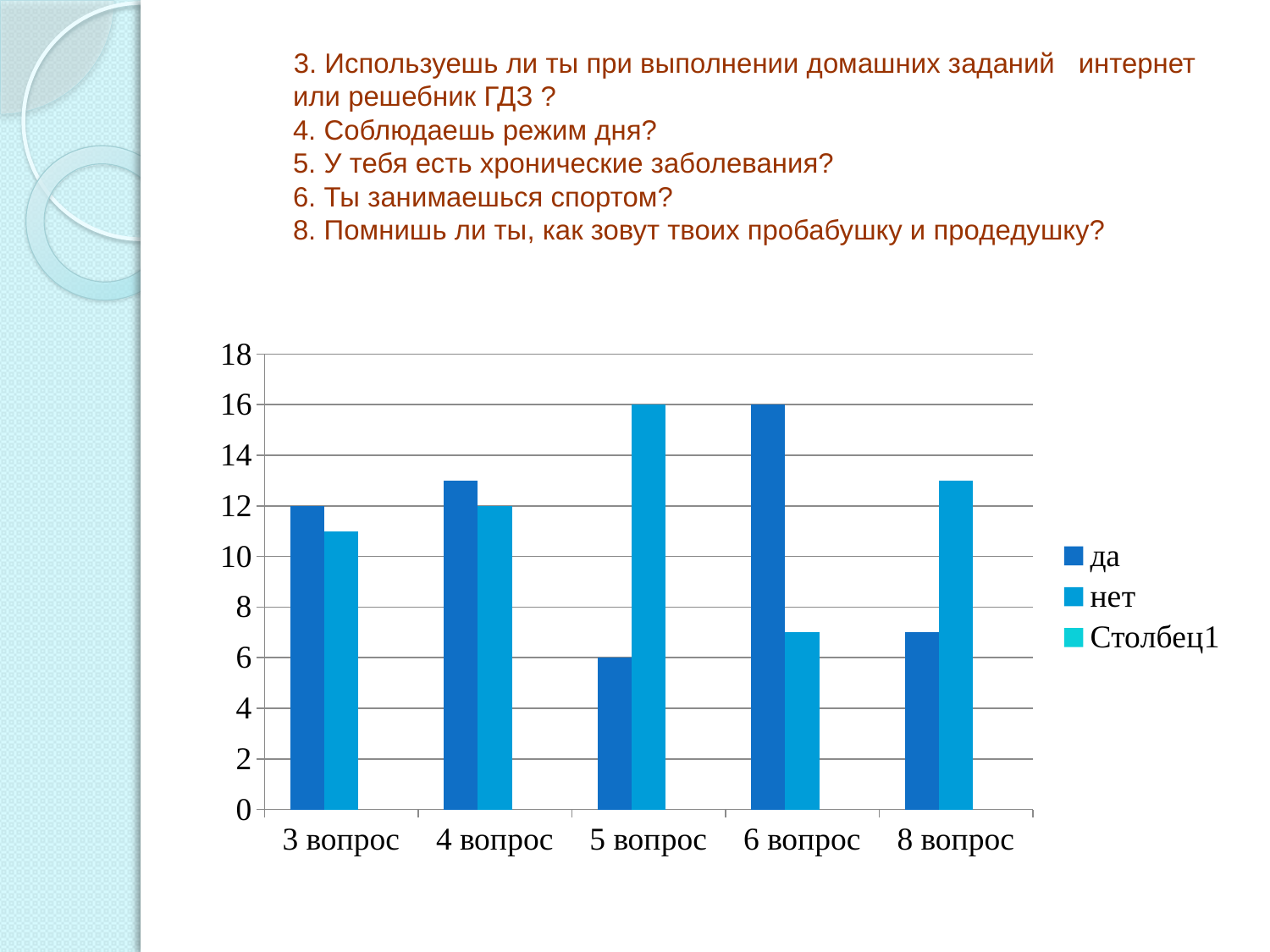
Which category has the highest value in the 'да' series? 6 вопрос Is the value of the 'нет' series for '6 вопрос' greater or less than 8? less For '5 вопрос', which series has the larger value, 'да' or 'нет'? нет How many series does the chart legend list? 3 What is the value of the 'да' series for '3 вопрос'? 12 How many categories are shown on the x axis of the chart? 5 Which category has the highest value in the 'нет' series? 5 вопрос What is the value of the 'да' series for '6 вопрос'? 16 Which category has the lowest value in the 'да' series? 5 вопрос What is the value of the 'нет' series for '5 вопрос'? 16 What is the difference between the 'да' values for '6 вопрос' and '5 вопрос'? 10 What type of chart is shown on the slide? bar chart